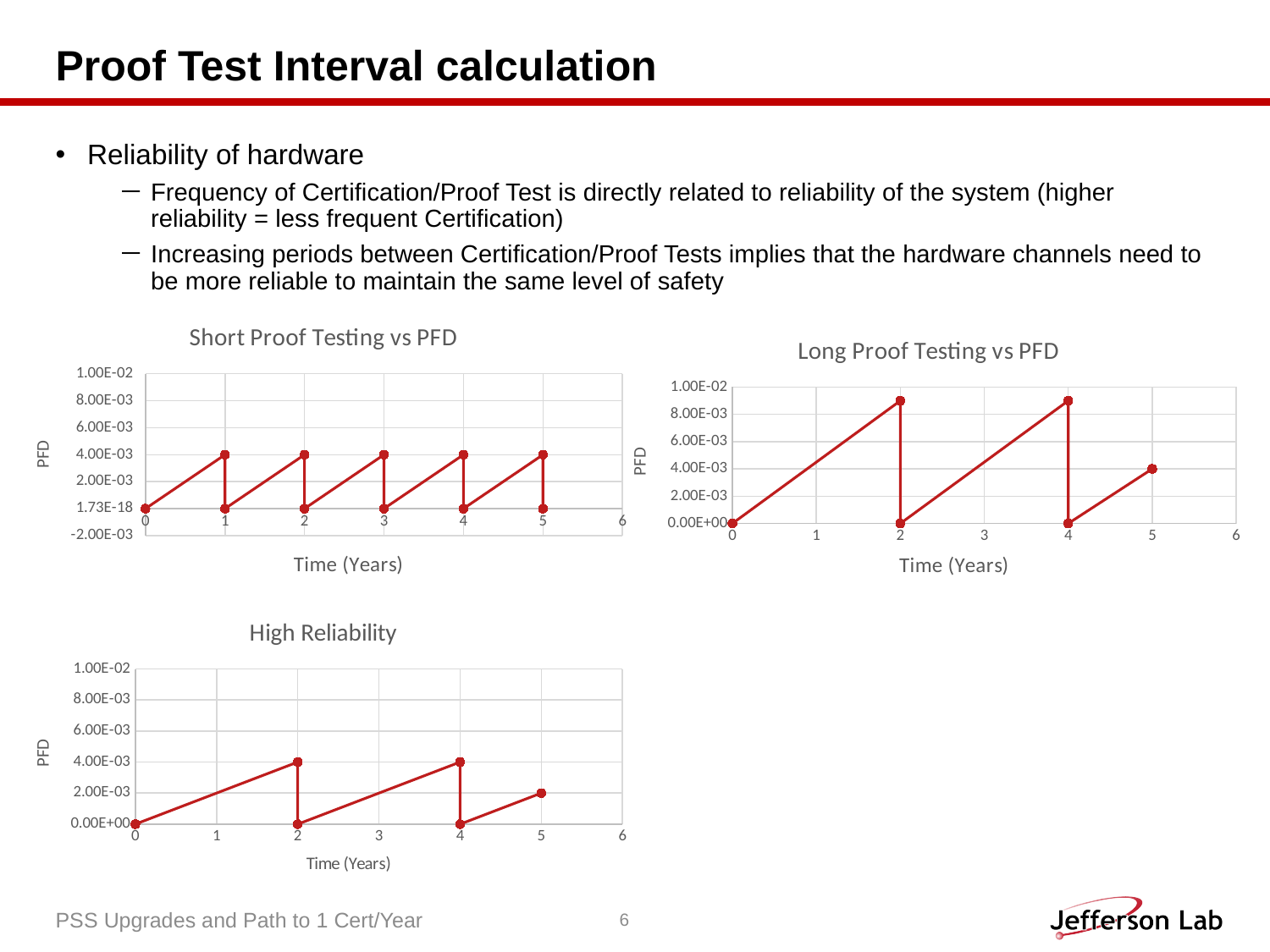
How many charts are shown on the slide? 3 In the "High Reliability" chart, is the PFD value at year 5 greater or less than 4.00E-03? less In the "Long Proof Testing vs PFD" chart, what is the PFD value at year 5? 4.00E-03 In the "Short Proof Testing vs PFD" chart, does the PFD rise or fall between year 0 and year 1? rise What is the x-axis label on the "Long Proof Testing vs PFD" chart? Time (Years) What kind of chart is the "Short Proof Testing vs PFD" chart? line chart In the "High Reliability" chart, what PFD value does the line reach at year 2 before dropping? 4.00E-03 What is the y-axis label on the "High Reliability" chart? PFD In the "High Reliability" chart, what is the PFD value at year 5? 2.00E-03 Which chart has the higher peak PFD value: "Short Proof Testing vs PFD" or "Long Proof Testing vs PFD"? Long Proof Testing vs PFD In the "Long Proof Testing vs PFD" chart, is the peak value at year 2 greater or less than 8.00E-03? greater In the "Short Proof Testing vs PFD" chart, what PFD value does the line reach at year 1 before dropping? 4.00E-03